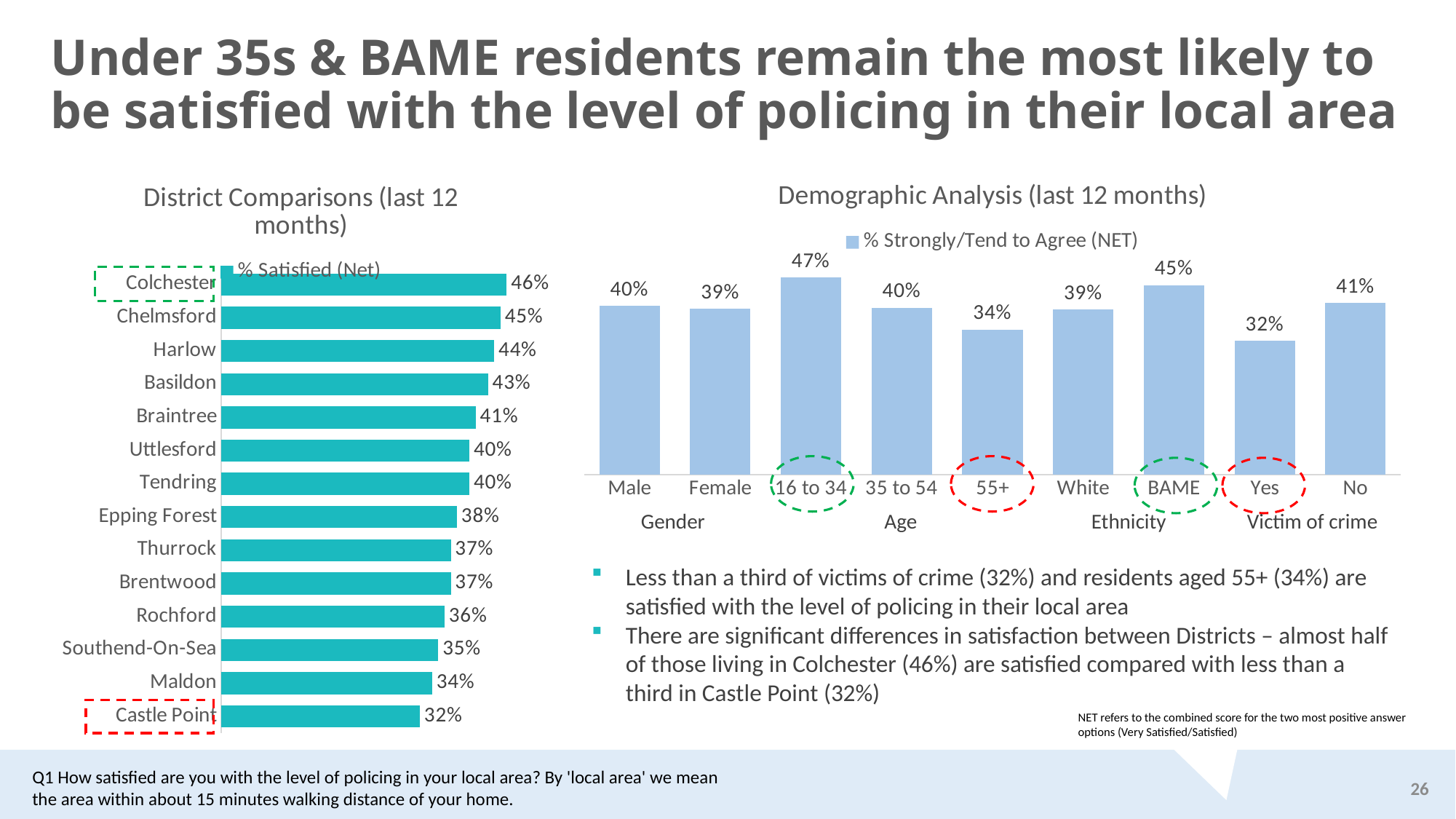
In the Demographic Analysis chart, which category has the lowest value? Yes In the District Comparisons chart, which district has the lowest % Satisfied (Net)? Castle Point In the District Comparisons chart, which district has the highest % Satisfied (Net)? Colchester In the Demographic Analysis chart, which category has the highest value? 16 to 34 In the District Comparisons chart, how many districts are shown? 14 In the Demographic Analysis chart, what is the difference between the values for No and Yes under Victim of crime? 9 percentage points In the Demographic Analysis chart, which is larger, the value for 16 to 34 or the value for 55+? 16 to 34 In the Demographic Analysis chart, what series does the legend list? % Strongly/Tend to Agree (NET) In the District Comparisons chart, what is the difference between Colchester and Castle Point? 14 percentage points In the District Comparisons chart, what is the value for Harlow? 44% What type of chart is the District Comparisons chart? Bar chart In the Demographic Analysis chart, what is the value for BAME? 45%